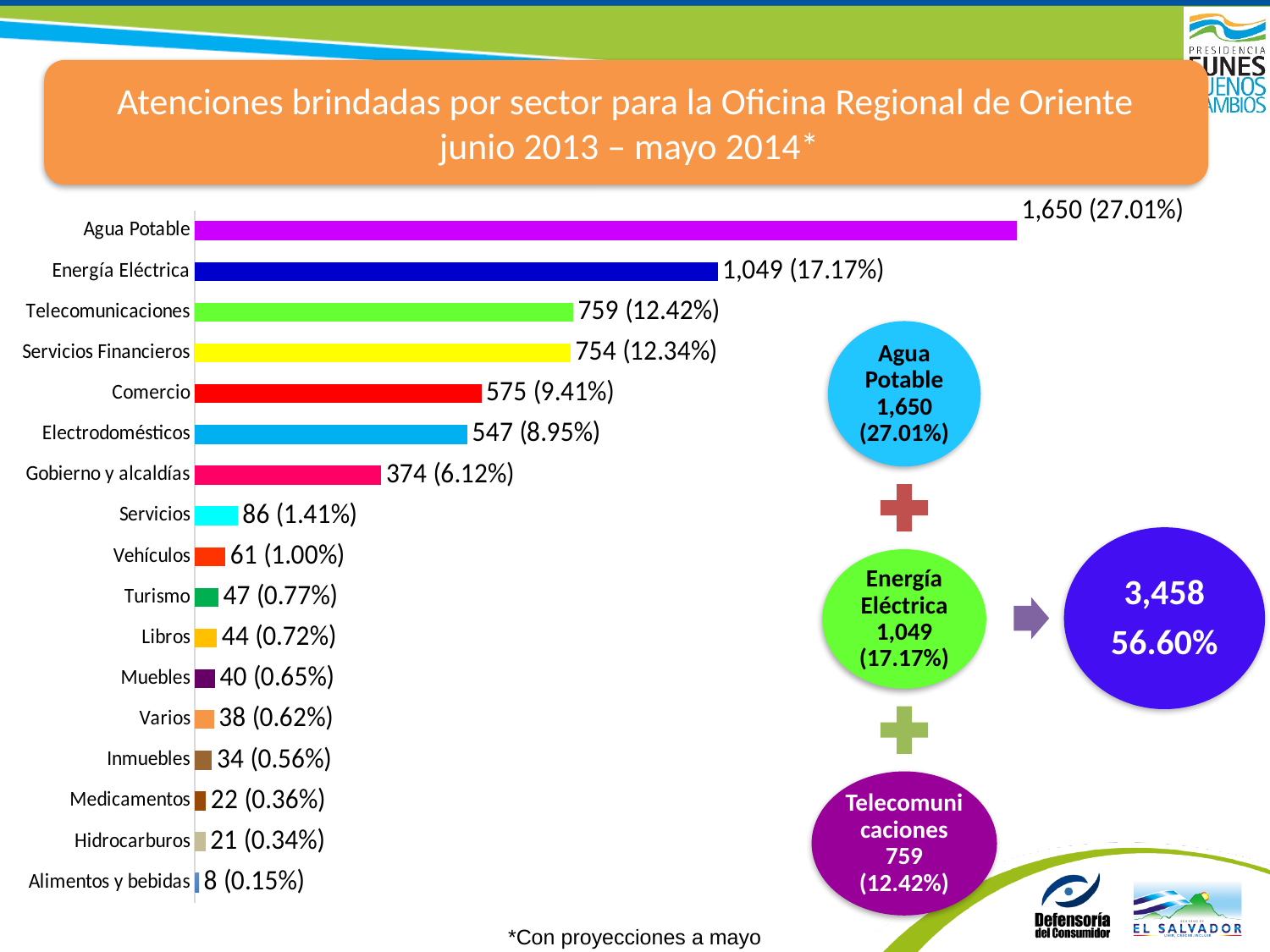
How many sectors (categories) are shown in the bar chart? 17 What is the data label shown for Hidrocarburos? 21 (0.34%) What is the title of the chart on the slide? Atenciones brindadas por sector para la Oficina Regional de Oriente junio 2013 – mayo 2014* What is the difference in atenciones between Telecomunicaciones and Servicios Financieros? 5 Which has more atenciones, Electrodomésticos or Gobierno y alcaldías? Electrodomésticos How many atenciones are shown for Comercio? 575 What percentage is shown for Gobierno y alcaldías? 6.12% What is the data label shown for Energía Eléctrica? 1,049 (17.17%) Which sector has the lowest number of atenciones in the bar chart? Alimentos y bebidas Which sector has the highest number of atenciones in the bar chart? Agua Potable What kind of chart is shown on the slide? bar chart What is the difference in atenciones between Agua Potable and Energía Eléctrica? 601